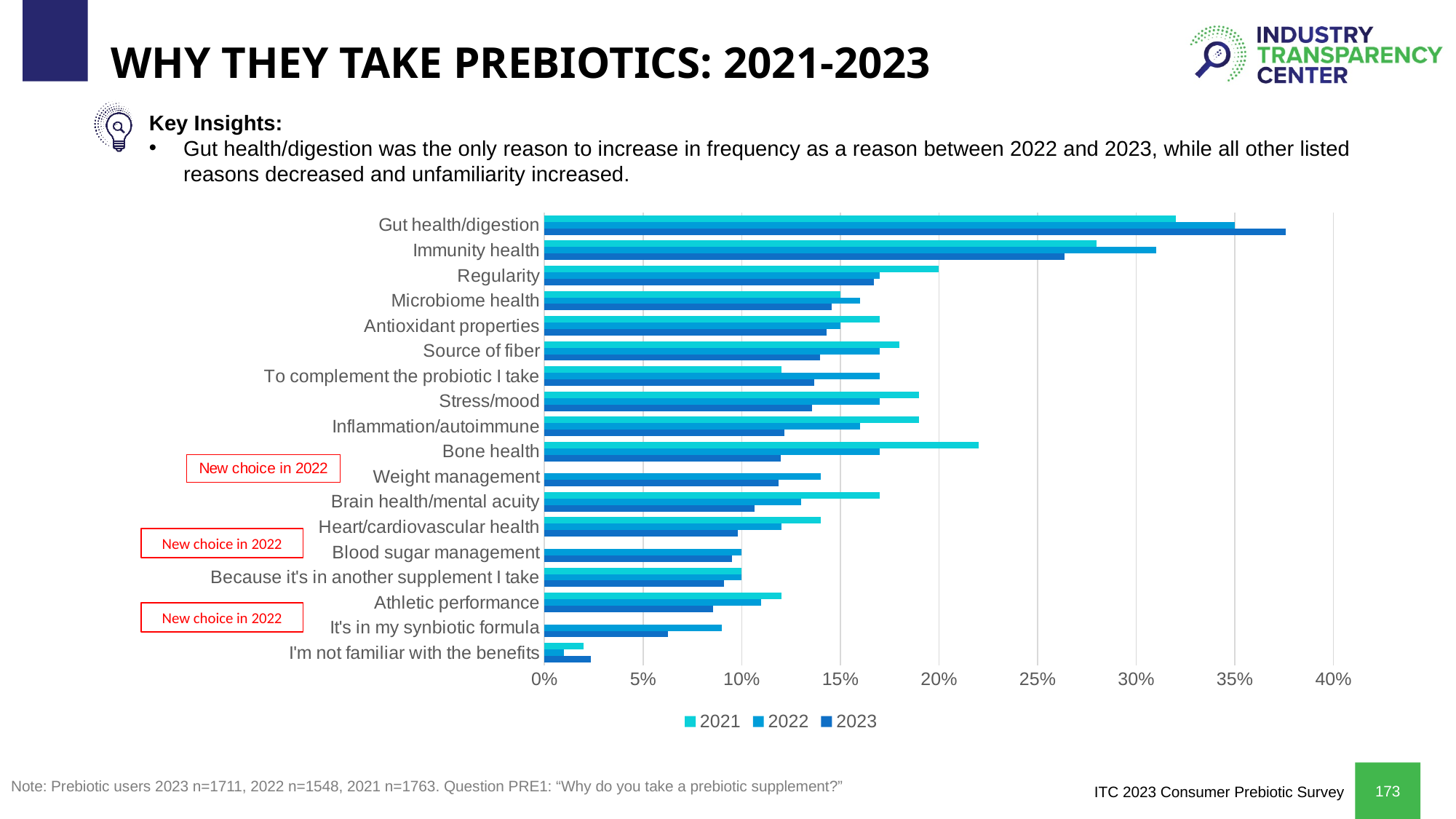
How many reasons are marked with a 'New choice in 2022' label? 3 Is the 2023 value for I'm not familiar with the benefits greater or less than 5%? less Which reason has the lowest value for 2023? I'm not familiar with the benefits Is the 2022 value for Immunity health greater or less than 30%? greater Is the 2023 value for Gut health/digestion greater or less than 35%? greater Which reason has the highest value for 2023? Gut health/digestion Which is larger for 2023: Gut health/digestion or Immunity health? Gut health/digestion What kind of chart is shown on the slide? Bar chart How many series does the legend list? 3 How many reasons (categories) are listed on the chart? 18